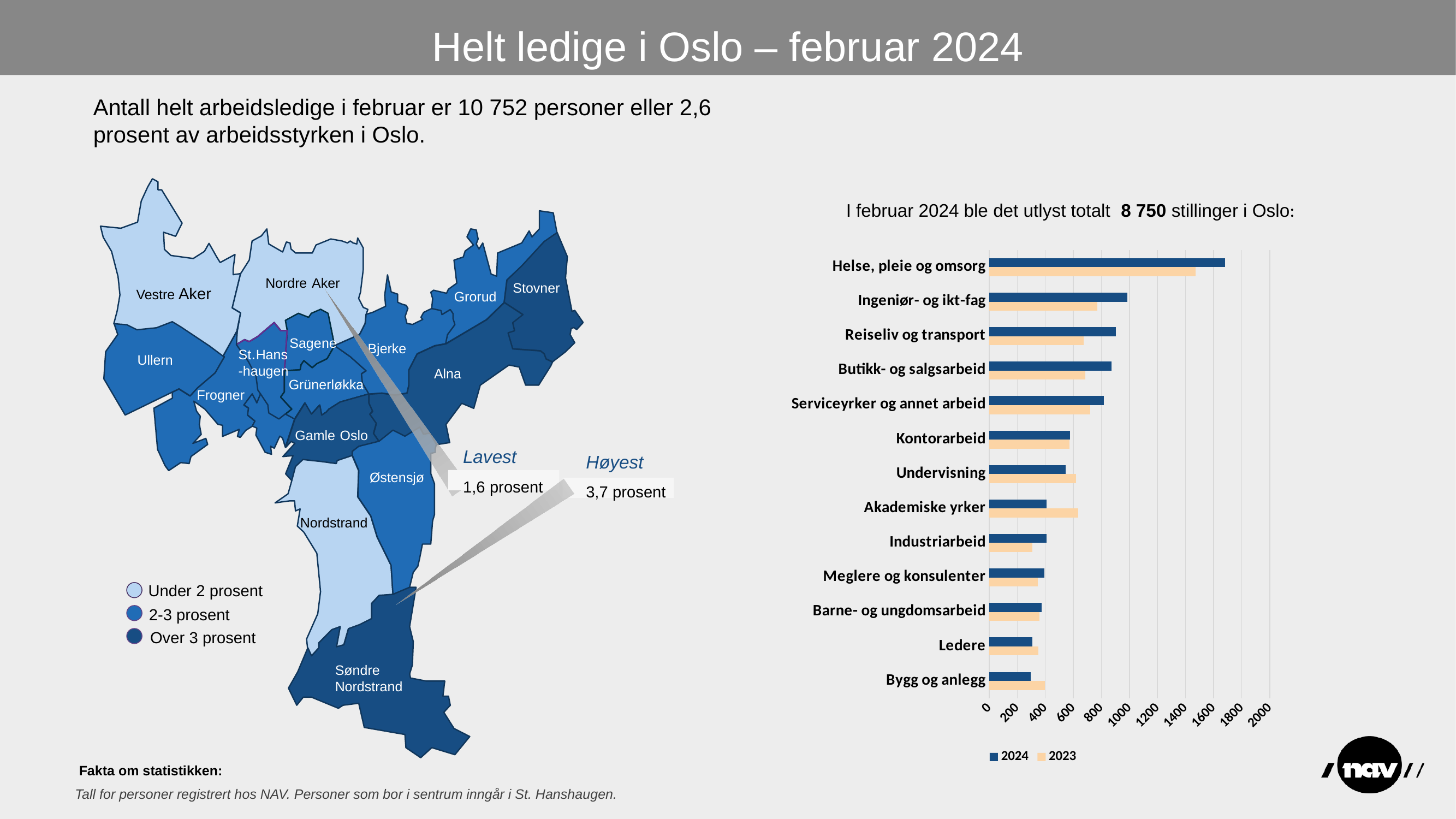
According to the text above the bar chart, how many job vacancies were advertised in Oslo in February 2024? 8 750 Which category has the highest value for 2024 in the bar chart? Helse, pleie og omsorg What kind of chart is shown on the right side of the slide? bar chart Which category has the highest value for 2023 in the bar chart? Helse, pleie og omsorg How many series does the bar chart's legend list? 2 In the bar chart, is the 2024 value for Bygg og anlegg greater or less than 400? less In the bar chart, is the 2024 value for Ingeniør- og ikt-fag greater or less than 800? greater In the bar chart, which is larger for Helse, pleie og omsorg: the 2024 value or the 2023 value? 2024 How many occupational categories are listed in the bar chart? 13 In the bar chart, is the 2024 value for Helse, pleie og omsorg greater or less than 1400? greater In the bar chart, which is larger for Akademiske yrker: the 2024 value or the 2023 value? 2023